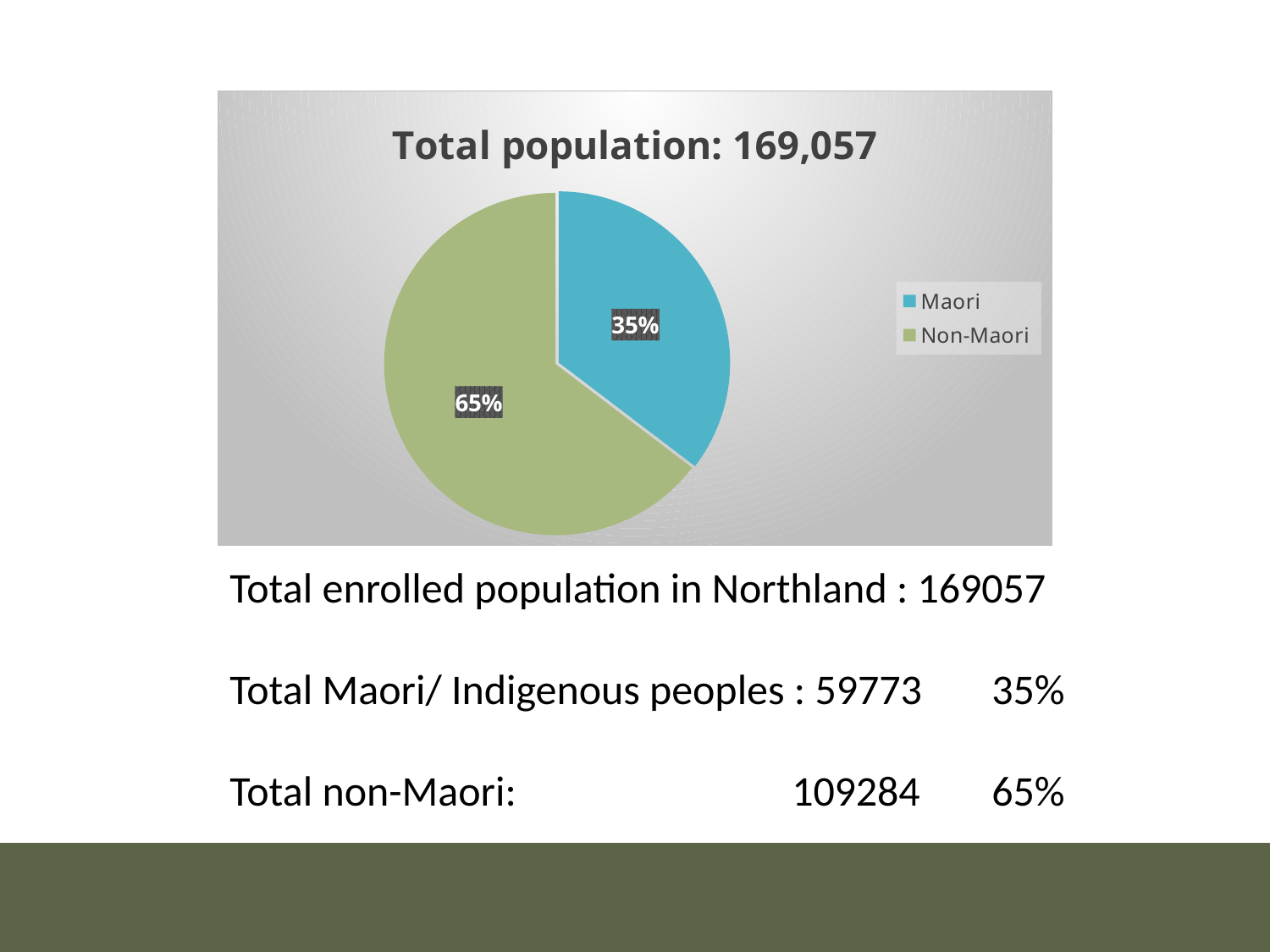
What is the difference in percentage points between the Non-Maori and Maori slices? 30 Which category has the smallest slice of the pie? Maori What kind of chart is shown on the slide? pie chart What is the title of the chart? Total population: 169,057 Which colour represents the Maori slice in the pie chart? blue What share of the pie does the Maori slice represent? 35% How many entries does the legend list? 2 How many categories does the pie chart show? 2 What share of the pie does the Non-Maori slice represent? 65% Which category has the largest slice of the pie? Non-Maori Which slice is larger, Maori or Non-Maori? Non-Maori